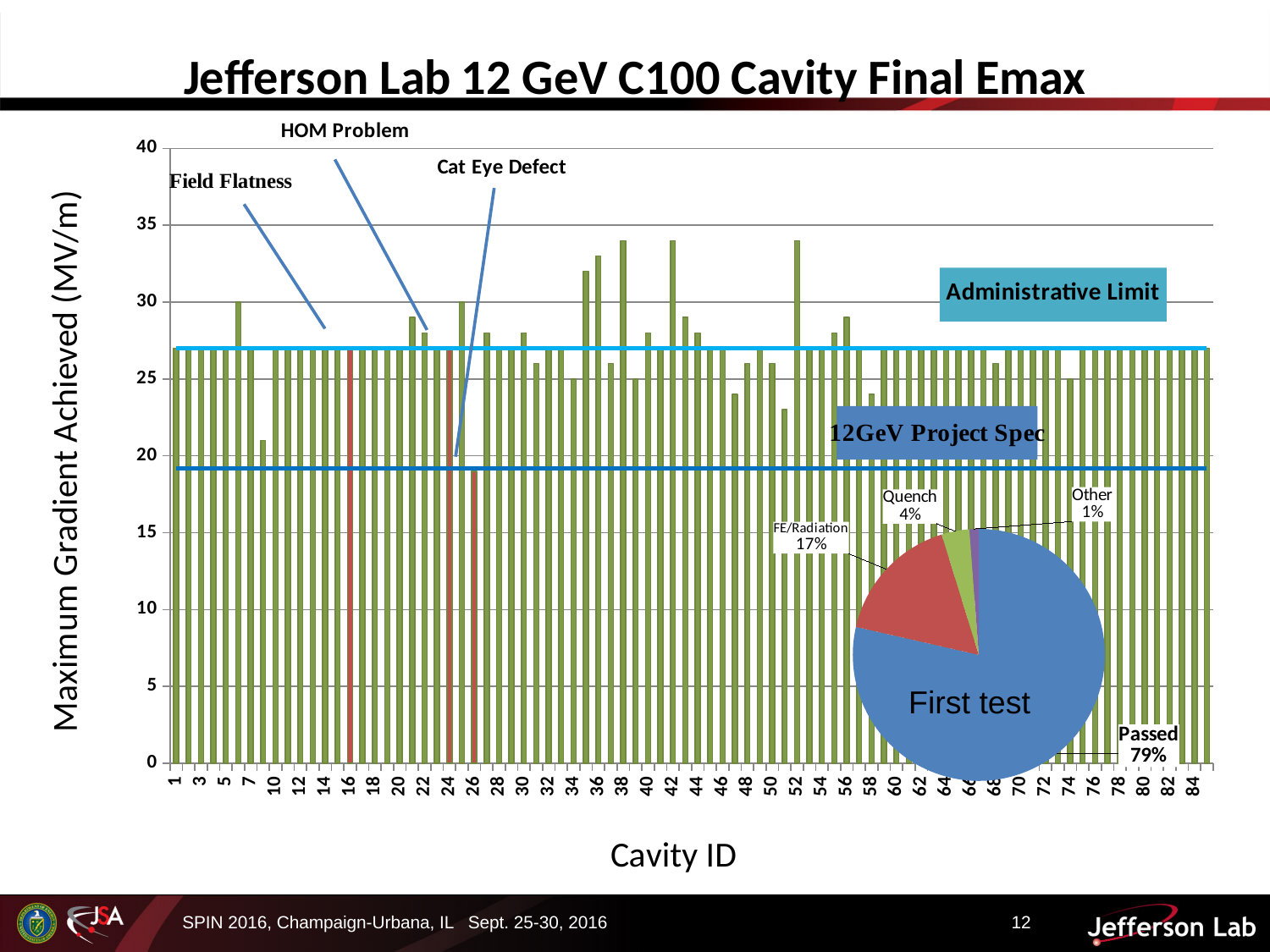
How many slices does the pie chart have? 4 In the bar chart, is the value for cavity 51 greater or less than 25? less In the pie chart, which is larger, the FE/Radiation slice or the Quench slice? FE/Radiation In the pie chart, what is the difference in percentage points between the Passed slice and the FE/Radiation slice? 62 In the pie chart, which slice is the smallest? Other In the pie chart, what share of cavities is labeled Passed? 79% In the bar chart, is the value for cavity 38 greater or less than 30? greater In the pie chart, which slice is the largest? Passed What kind of chart is the large chart plotting Maximum Gradient Achieved against Cavity ID? bar chart In the pie chart, what percentage is labeled Quench? 4% What is the label of the x axis of the bar chart? Cavity ID In the pie chart, what percentage is labeled FE/Radiation? 17%